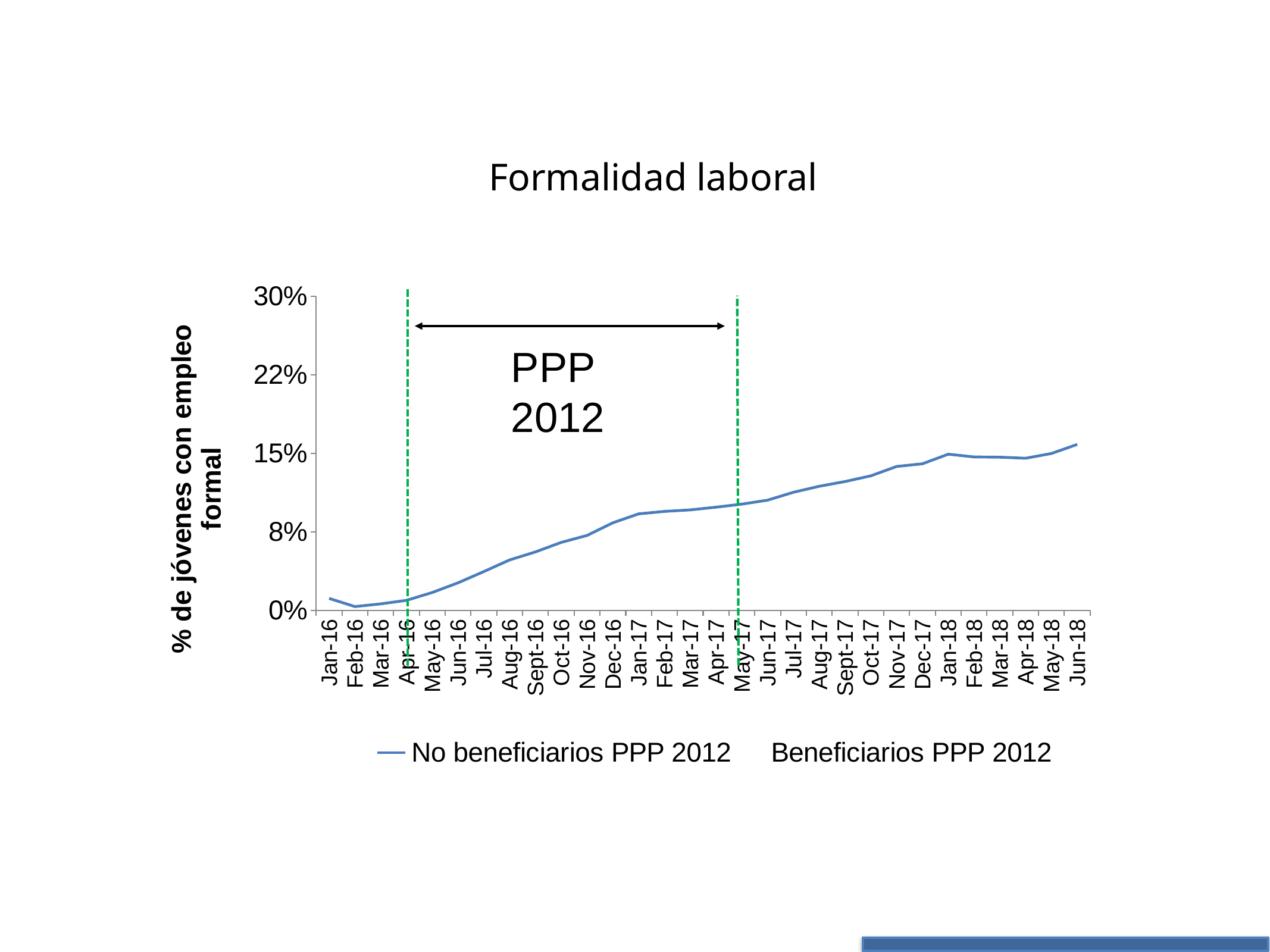
In which month is the No beneficiarios PPP 2012 line at its highest? Jun-18 What is the title of the chart? Formalidad laboral What kind of chart is shown on the slide? line chart Is the value for No beneficiarios PPP 2012 in Jan-17 greater or less than 8%? greater Which is larger, the value for No beneficiarios PPP 2012 in Apr-17 or in Apr-16? Apr-17 Does the No beneficiarios PPP 2012 line generally rise or fall from Jan-16 to Jun-18? rise Is the value for No beneficiarios PPP 2012 in Jun-18 greater or less than 15%? greater How many months are shown along the x axis? 30 Is the value for No beneficiarios PPP 2012 in Aug-16 greater or less than 8%? less In which month is the No beneficiarios PPP 2012 line at its lowest? Feb-16 How many series does the legend list? 2 What label is written on the y axis of the chart? % de jóvenes con empleo formal